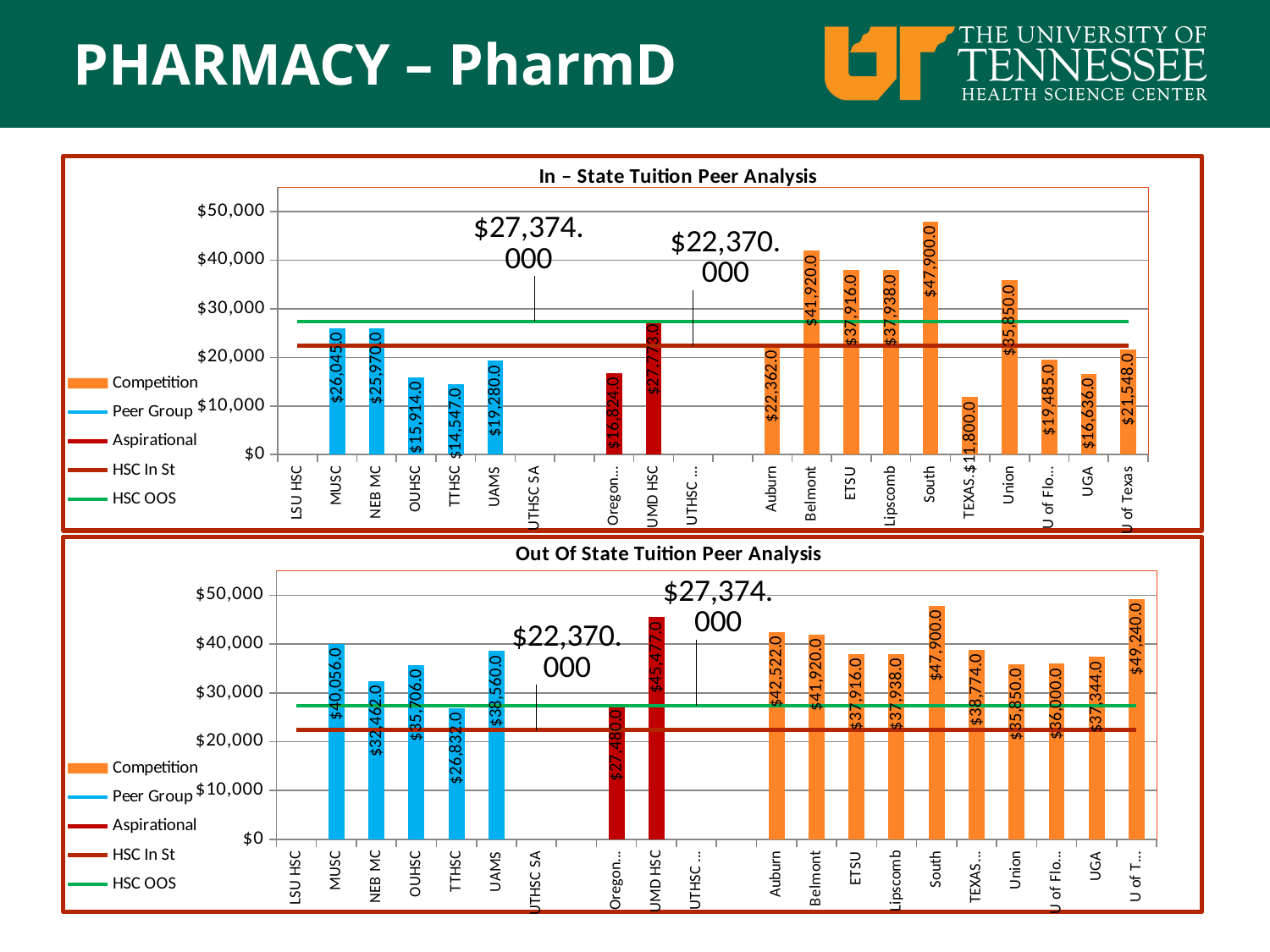
In the In – State Tuition Peer Analysis chart, what is the difference between Belmont and ETSU? $4,004.0 How many entries does the legend of the In – State Tuition Peer Analysis chart list? 5 In the Out Of State Tuition Peer Analysis chart, what is the value for MUSC? $40,056.0 In the Out Of State Tuition Peer Analysis chart, is the value for Oregon greater or less than $30,000? less In the In – State Tuition Peer Analysis chart, what is the value for Belmont? $41,920.0 In the Out Of State Tuition Peer Analysis chart, what is the difference between MUSC and NEB MC? $7,594.0 In the Out Of State Tuition Peer Analysis chart, which category has the lowest value? TTHSC In the In – State Tuition Peer Analysis chart, what is the value for UAMS? $19,280.0 In the In – State Tuition Peer Analysis chart, which is larger, Union or Auburn? Union In the In – State Tuition Peer Analysis chart, which category has the lowest value? TEXAS In the In – State Tuition Peer Analysis chart, which category has the highest value? South In the Out Of State Tuition Peer Analysis chart, what is the value for UMD HSC? $45,477.0